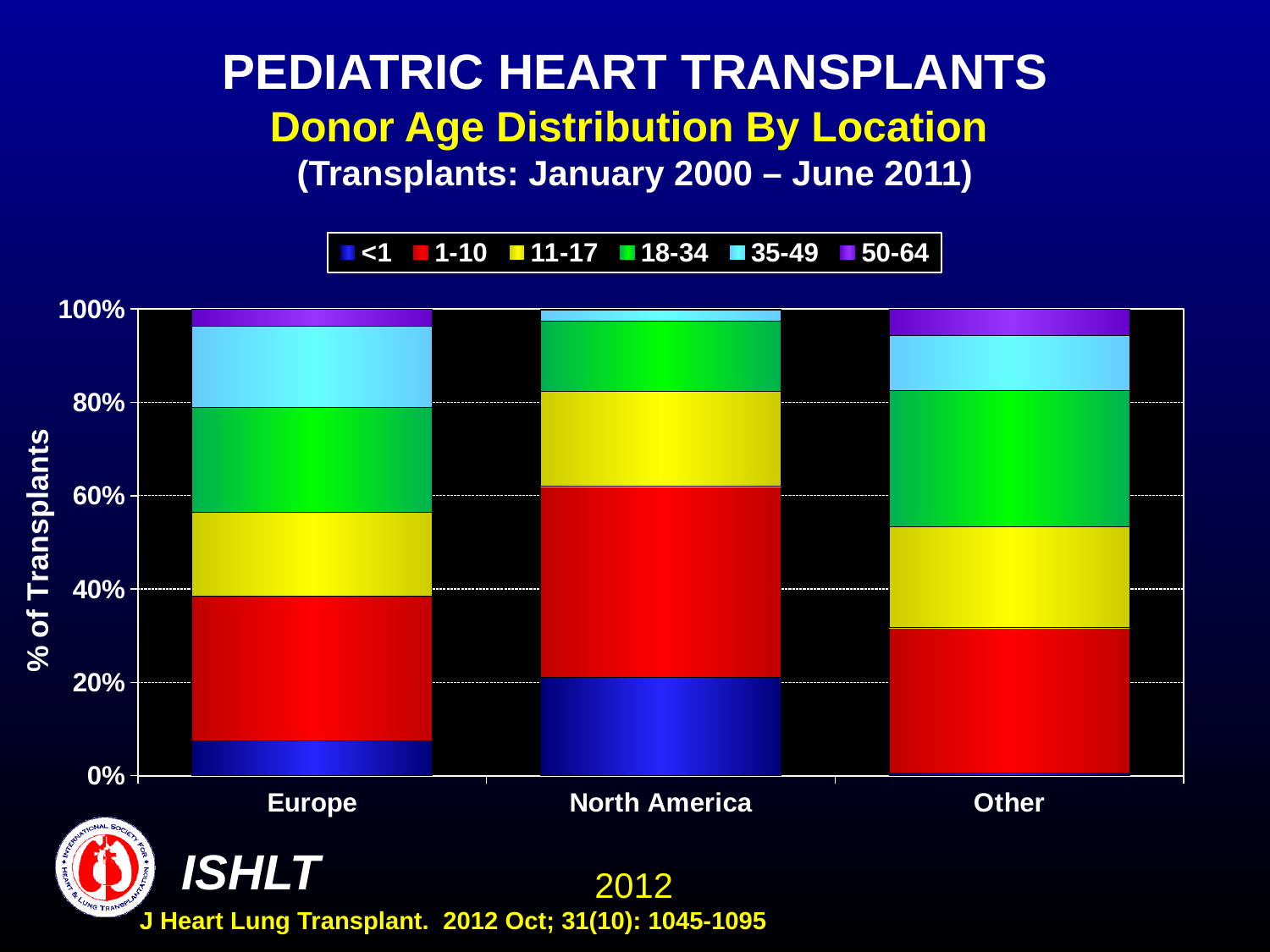
How many donor age groups does the legend list? 6 Is the share of donors aged 18-34 in Other greater or less than 20%? greater What is the total height of the stacked bar for Europe? 100% Which location has the largest share of donors aged <1? North America Is the share of donors aged <1 larger for Europe or for North America? North America What kind of chart is shown on the slide? stacked bar chart Which location has the largest share of donors aged 18-34? Other Which location has the largest share of donors aged 1-10? North America What is the label of the y axis? % of Transplants Is the share of donors aged 1-10 in Europe greater or less than 20%? greater Which donor age group is shown in red in the legend? 1-10 How many locations are shown on the x axis of the chart? 3